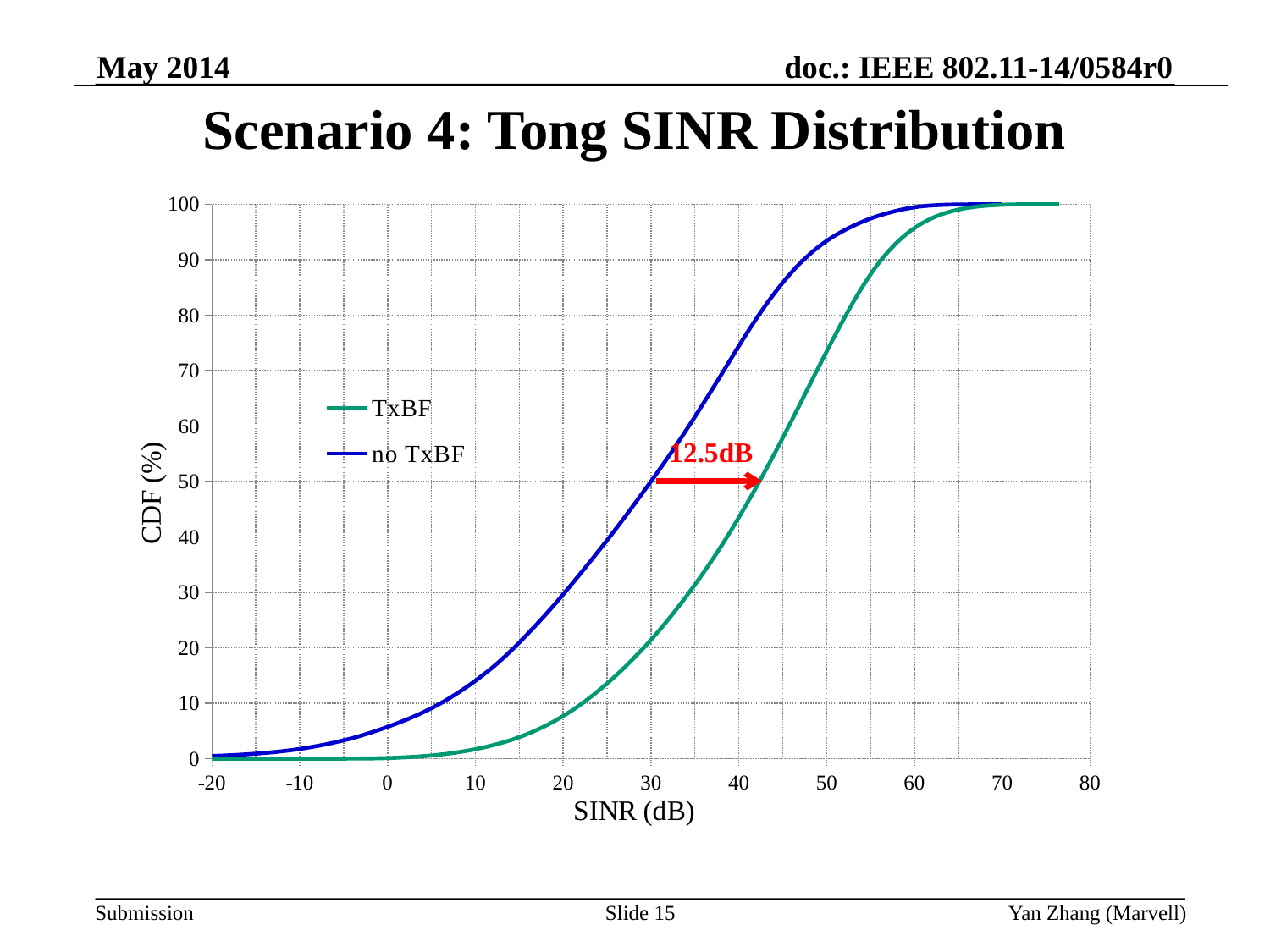
How many series does the legend list? 2 What is the title of the chart on the slide? Scenario 4: Tong SINR Distribution What are the two series named in the legend? TxBF and no TxBF At an SINR of 50 dB, is the CDF value for TxBF greater or less than 60? greater At an SINR of 0 dB, is the CDF value for no TxBF greater or less than 10? less At an SINR of 30 dB, which series has the higher CDF value, TxBF or no TxBF? no TxBF Do the CDF values rise or fall as SINR increases along the x axis? rise What SINR gap is annotated by the red arrow between the two curves at 50% CDF? 12.5dB What kind of chart is shown on the slide? line chart At an SINR of 30 dB, is the CDF value for TxBF greater or less than 30? less